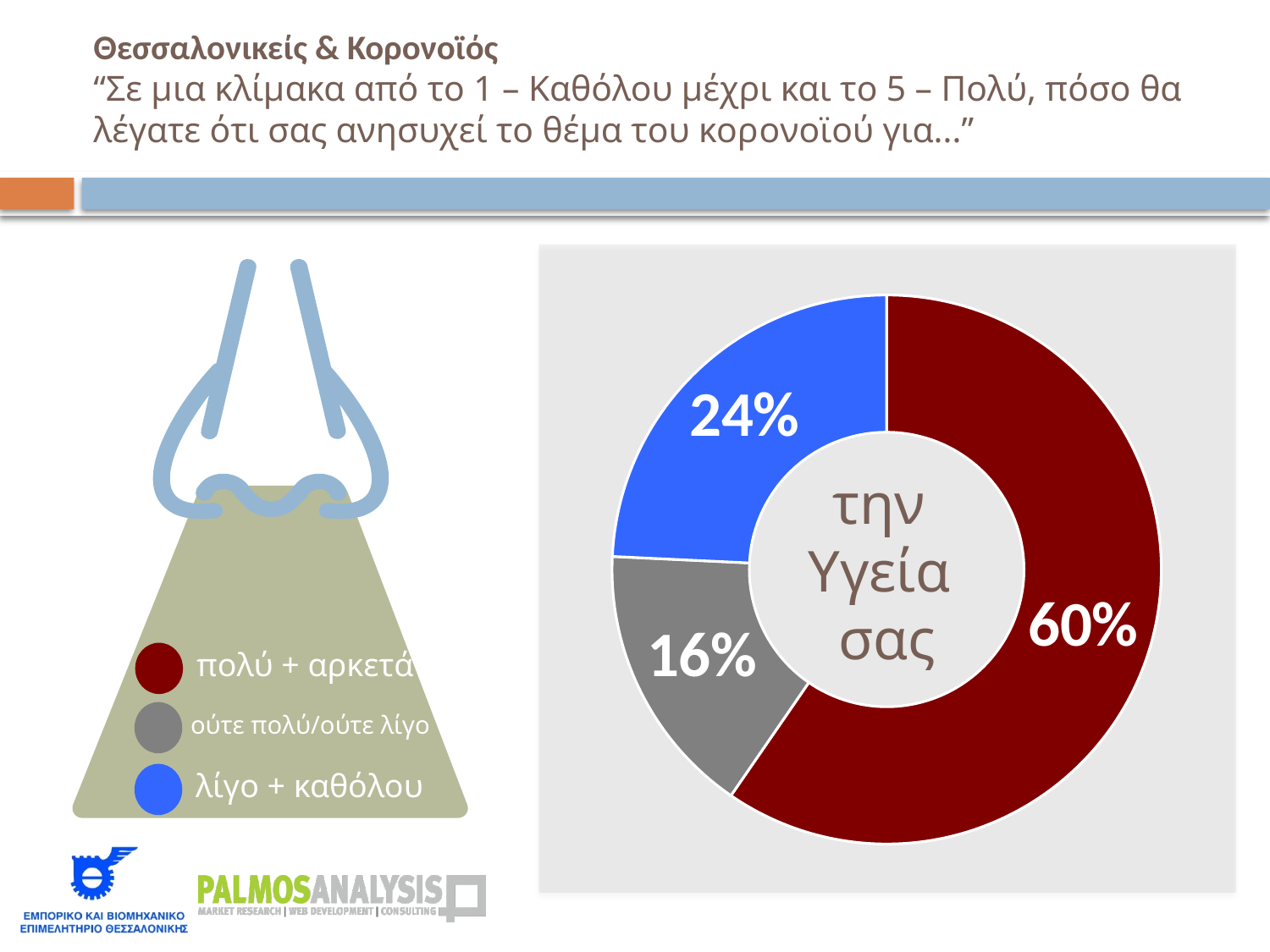
What text is written in the centre of the doughnut chart? την Υγεία σας What percentage is shown for the "λίγο + καθόλου" (blue) slice? 24% What is the difference in percentage points between the "πολύ + αρκετά" slice and the "λίγο + καθόλου" slice? 36 How many slices does the chart have? 3 What percentage is shown for the "πολύ + αρκετά" (dark red) slice? 60% Which category has the largest share of the chart? πολύ + αρκετά Which is larger: the "λίγο + καθόλου" slice or the "ούτε πολύ/ούτε λίγο" slice? λίγο + καθόλου What percentage is shown for the "ούτε πολύ/ούτε λίγο" (grey) slice? 16% What kind of chart is shown on the slide? doughnut (pie) chart How many categories does the legend list? 3 What colour is the "λίγο + καθόλου" slice? blue Which category has the smallest share of the chart? ούτε πολύ/ούτε λίγο